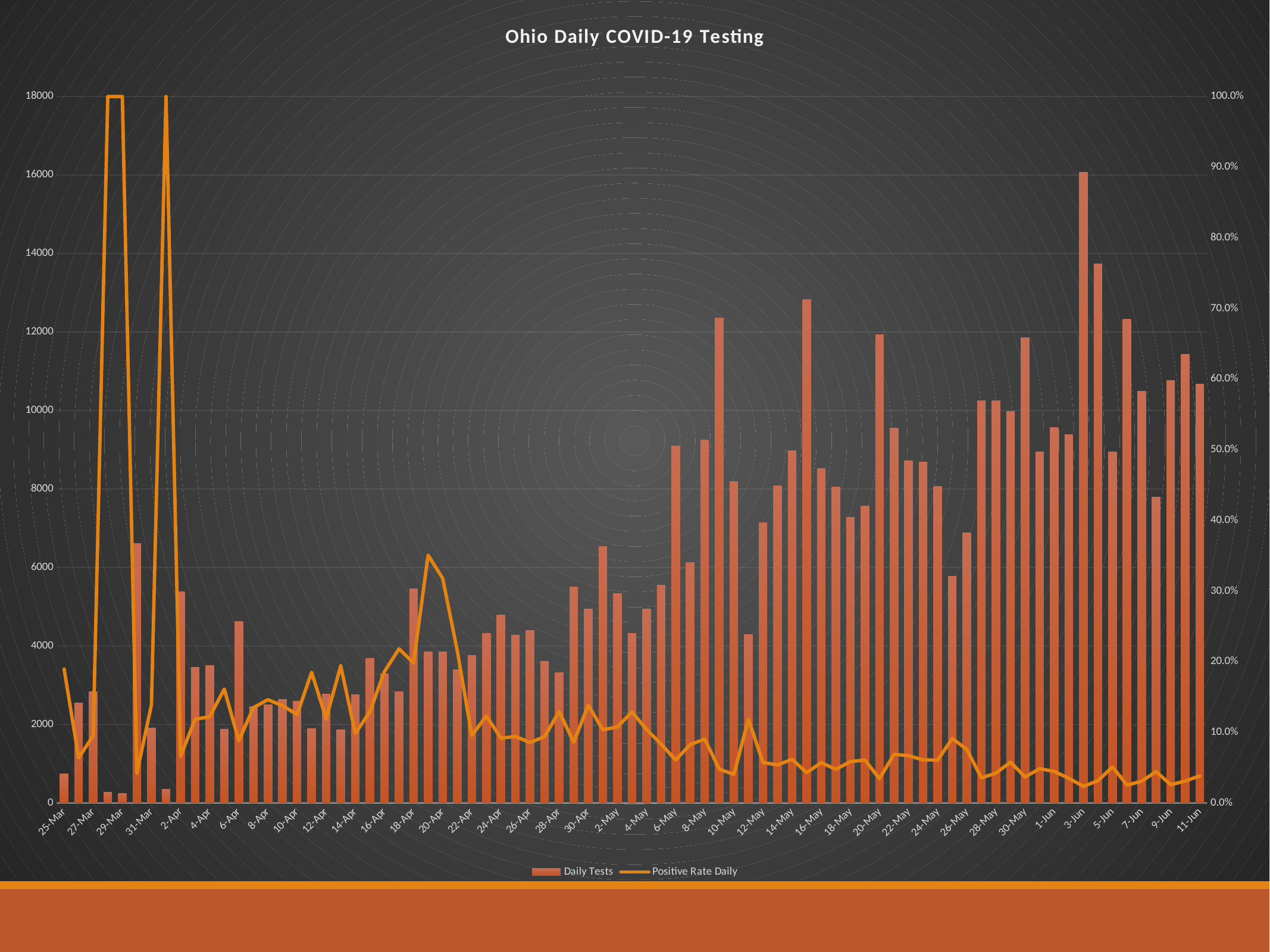
Does the Positive Rate Daily line generally rise or fall from 20-Apr to 11-Jun? fall Is the Daily Tests value for 3-Jun greater or less than 14000? greater What is the title of the chart? Ohio Daily COVID-19 Testing Is the Daily Tests value for 25-Mar greater or less than 2000? less Which series is drawn as a line rather than bars? Positive Rate Daily On which date is the Daily Tests bar the highest? 3-Jun How many series does the legend list? 2 What kind of chart is shown on the slide? Combined bar and line chart Is the Positive Rate Daily value for 11-Jun greater or less than 10.0%? less